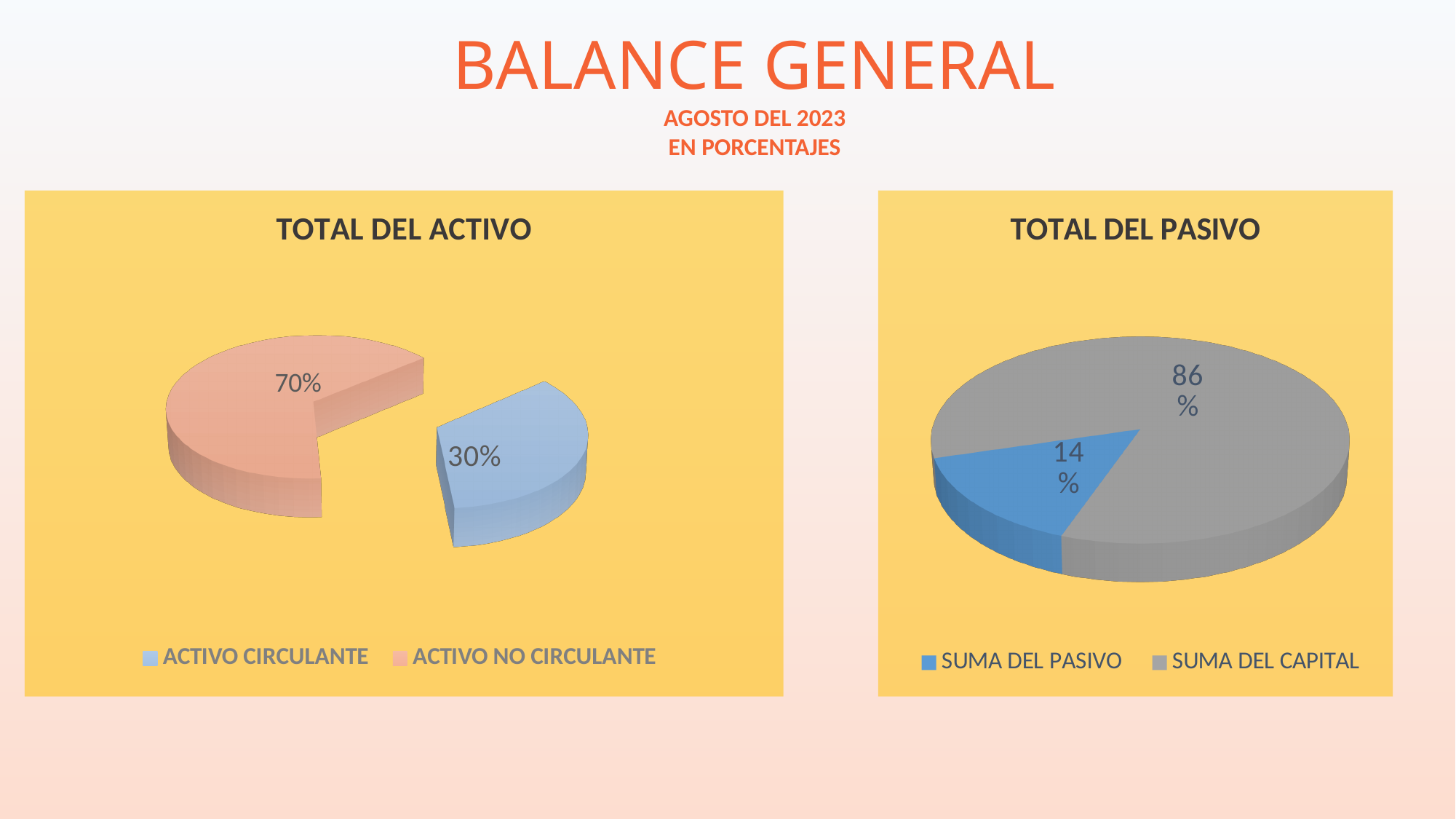
In the TOTAL DEL PASIVO chart, what is the difference between SUMA DEL CAPITAL and SUMA DEL PASIVO? 72% In the TOTAL DEL ACTIVO chart, which category has the largest share? ACTIVO NO CIRCULANTE In the TOTAL DEL ACTIVO chart, what colour is the ACTIVO CIRCULANTE slice? Light blue How many slices does the TOTAL DEL PASIVO chart have? 2 In the TOTAL DEL PASIVO chart, which category has the smallest share? SUMA DEL PASIVO In the TOTAL DEL ACTIVO chart, what is the difference between ACTIVO NO CIRCULANTE and ACTIVO CIRCULANTE? 40% In the TOTAL DEL PASIVO chart, what is the value for SUMA DEL PASIVO? 14% In the TOTAL DEL PASIVO chart, which is larger, SUMA DEL PASIVO or SUMA DEL CAPITAL? SUMA DEL CAPITAL In the TOTAL DEL ACTIVO chart, what is the value for ACTIVO NO CIRCULANTE? 70% In the TOTAL DEL ACTIVO chart, what is the value for ACTIVO CIRCULANTE? 30% In the TOTAL DEL PASIVO chart, what is the value for SUMA DEL CAPITAL? 86% What kind of chart is the TOTAL DEL ACTIVO chart? Pie chart